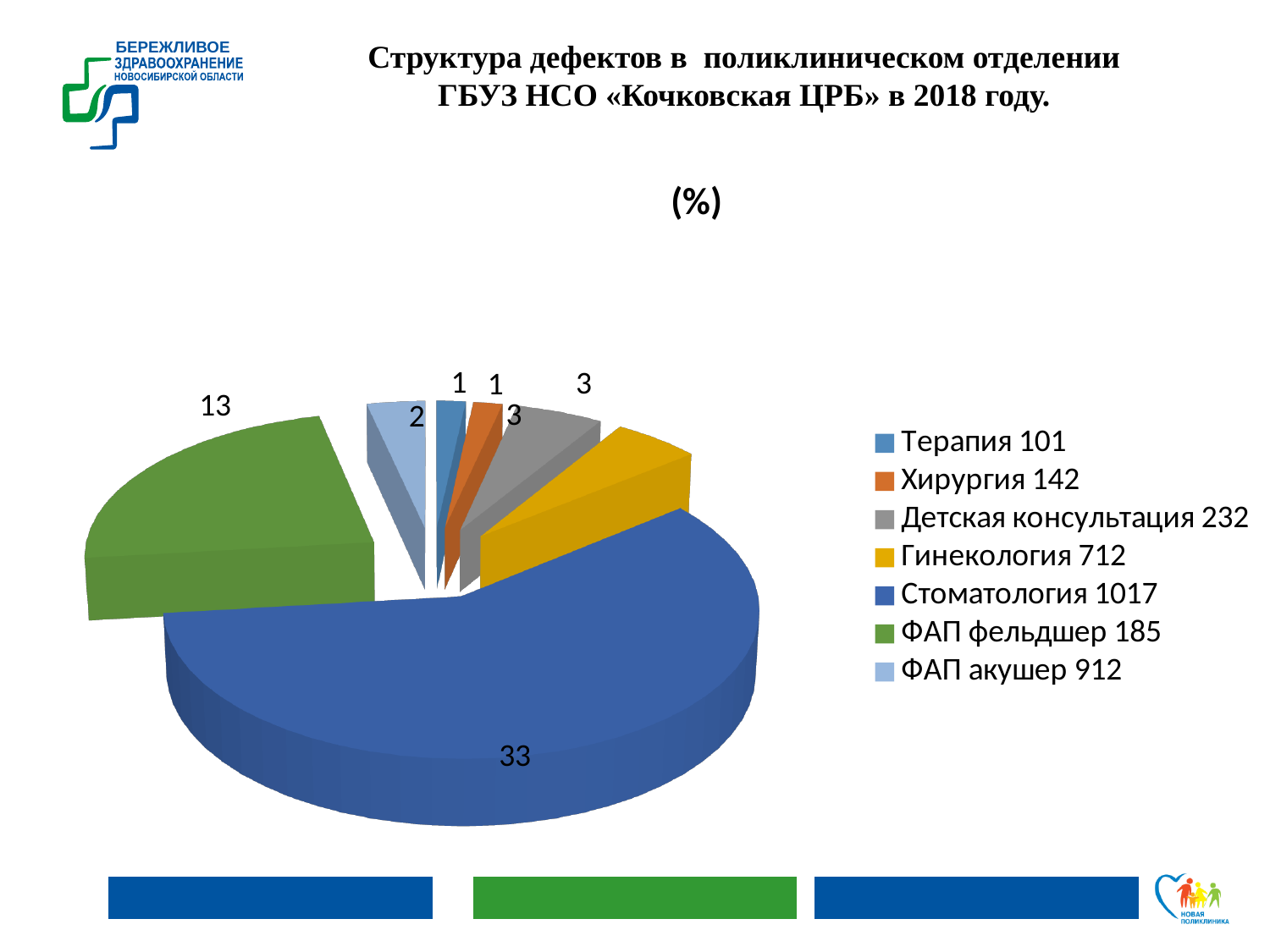
What is the value shown for ФАП фельдшер 185 in the pie chart? 13 How many categories does the pie chart have? 7 What is the difference between the values for Стоматология 1017 and ФАП фельдшер 185? 20 What is the title of the chart? (%) What type of chart is shown on the slide? pie chart Which is larger, the slice for Стоматология 1017 or the slice for ФАП фельдшер 185? Стоматология 1017 Which category has the largest slice in the pie chart? Стоматология 1017 What colour is the slice for ФАП фельдшер 185? green What is the value shown for Терапия 101 in the pie chart? 1 What is the value shown for ФАП акушер 912 in the pie chart? 2 What is the value shown for Гинекология 712 in the pie chart? 3 What is the value shown for Стоматология 1017 in the pie chart? 33